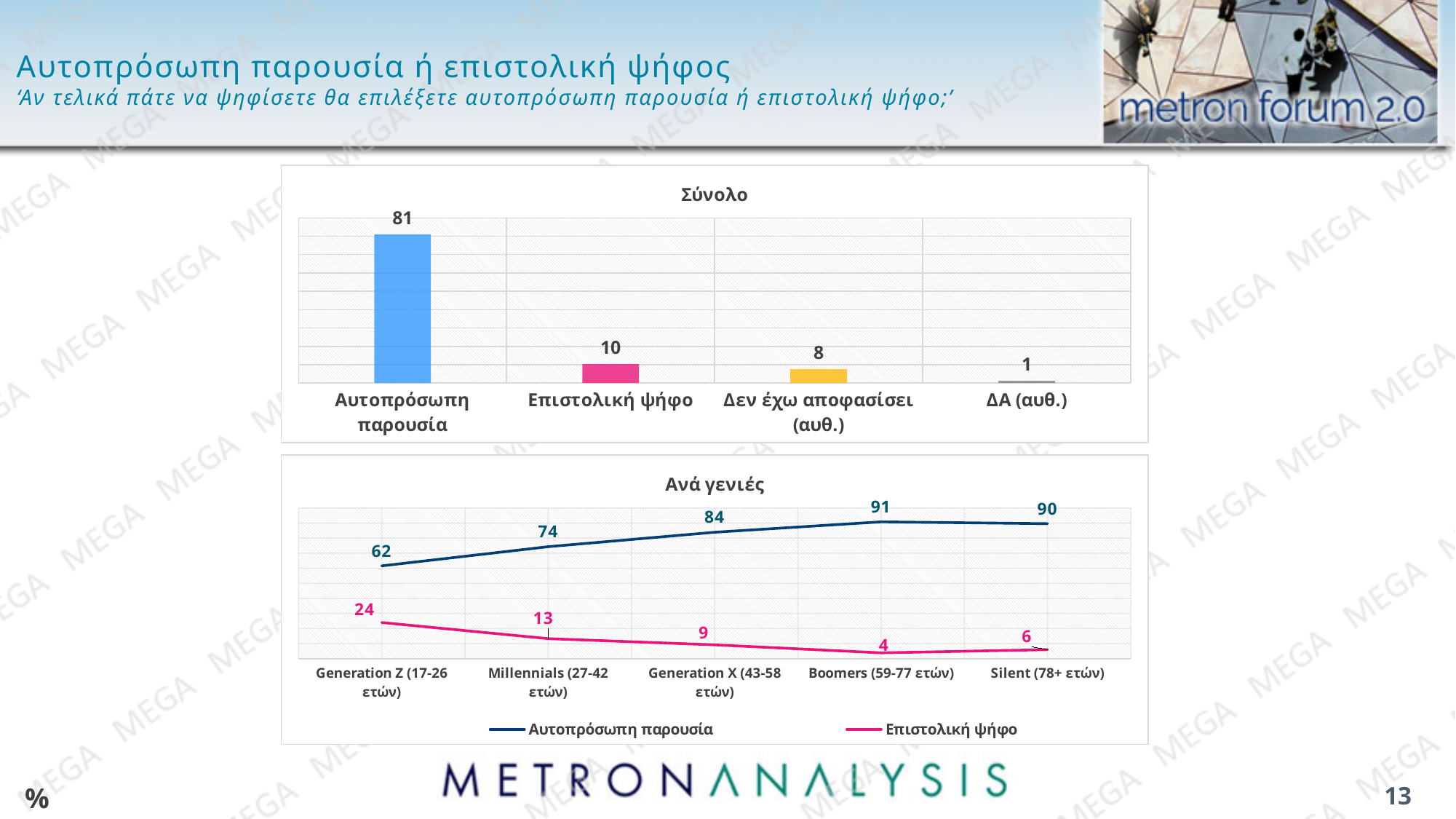
In the 'Σύνολο' chart, which category has the lowest value? ΔΑ (αυθ.) In the 'Σύνολο' chart, what is the difference between 'Επιστολική ψήφο' and 'Δεν έχω αποφασίσει (αυθ.)'? 2 In the 'Ανά γενιές' chart, which generation has the highest value for 'Αυτοπρόσωπη παρουσία'? Boomers (59-77 ετών) In the 'Ανά γενιές' chart, what is the value for 'Επιστολική ψήφο' for Generation Z (17-26 ετών)? 24 In the 'Σύνολο' chart, what is the value for 'Αυτοπρόσωπη παρουσία'? 81 In the 'Ανά γενιές' chart, what is the value for 'Αυτοπρόσωπη παρουσία' for Millennials (27-42 ετών)? 74 What kind of chart is the 'Σύνολο' chart? Bar chart In the 'Ανά γενιές' chart, what is the difference between 'Αυτοπρόσωπη παρουσία' and 'Επιστολική ψήφο' for Generation X (43-58 ετών)? 75 In the 'Ανά γενιές' chart, does the 'Επιστολική ψήφο' line generally rise or fall from Generation Z to Boomers? Fall In the 'Ανά γενιές' chart, which generation has the lowest value for 'Επιστολική ψήφο'? Boomers (59-77 ετών) In the 'Ανά γενιές' chart, how many series does the legend list? 2 In the 'Σύνολο' chart, how many categories are shown? 4